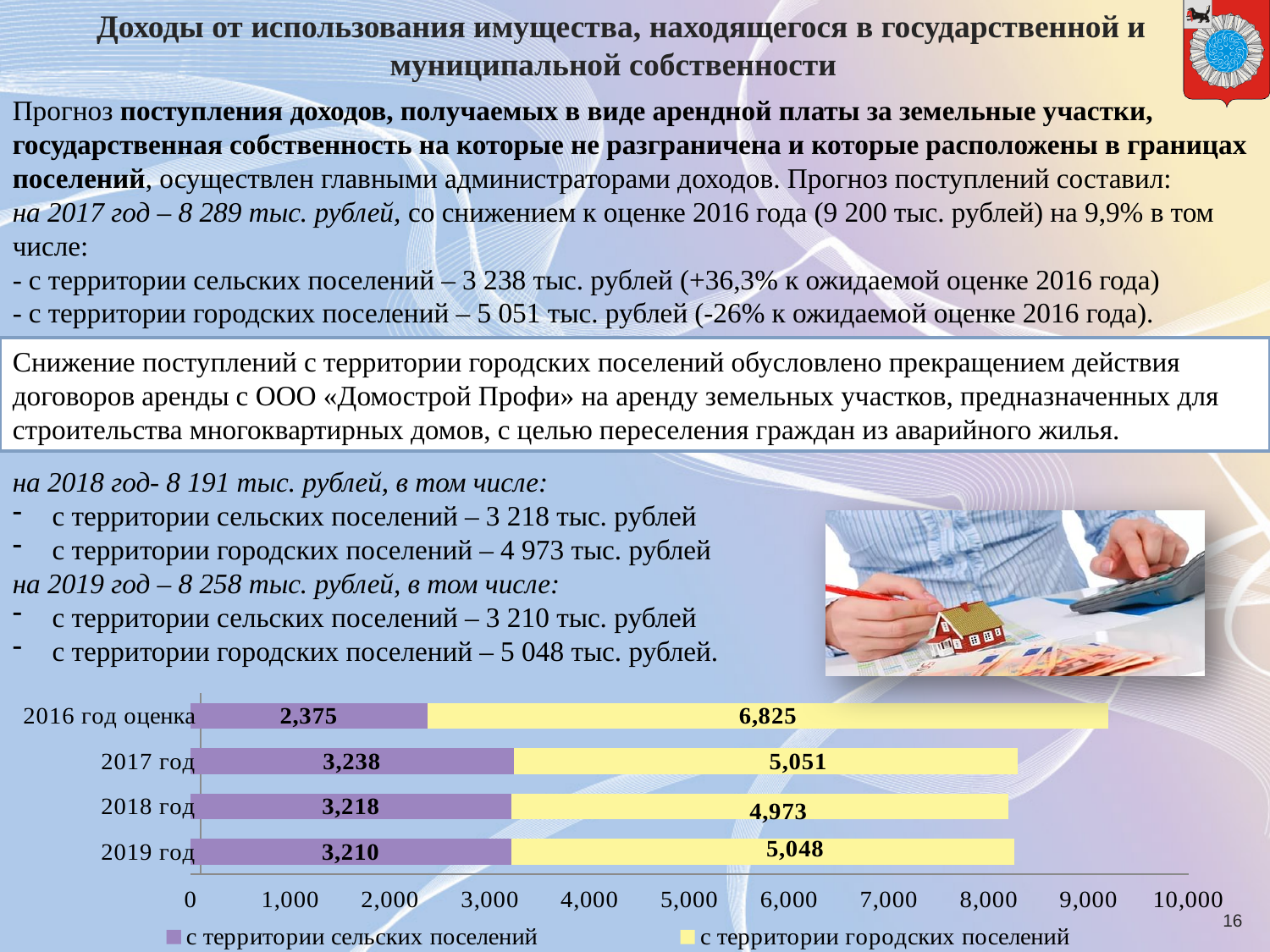
Which is larger in 2019 год: 'с территории сельских поселений' or 'с территории городских поселений'? с территории городских поселений Which year has the highest value for 'с территории городских поселений'? 2016 год оценка What kind of chart is shown at the bottom of the slide? Stacked bar chart What is the value for 'с территории городских поселений' in 2017 год? 5,051 What is the total of the stacked bar for 2016 год оценка? 9,200 What is the value for 'с территории сельских поселений' in 2016 год оценка? 2,375 What is the difference between the 'с территории городских поселений' values for 2016 год оценка and 2017 год? 1,774 Which year has the lowest value for 'с территории сельских поселений'? 2016 год оценка Which colour represents 'с территории сельских поселений' in the chart? Purple What is the value for 'с территории городских поселений' in 2018 год? 4,973 How many categories (years) are shown on the chart? 4 How many series does the chart legend list? 2